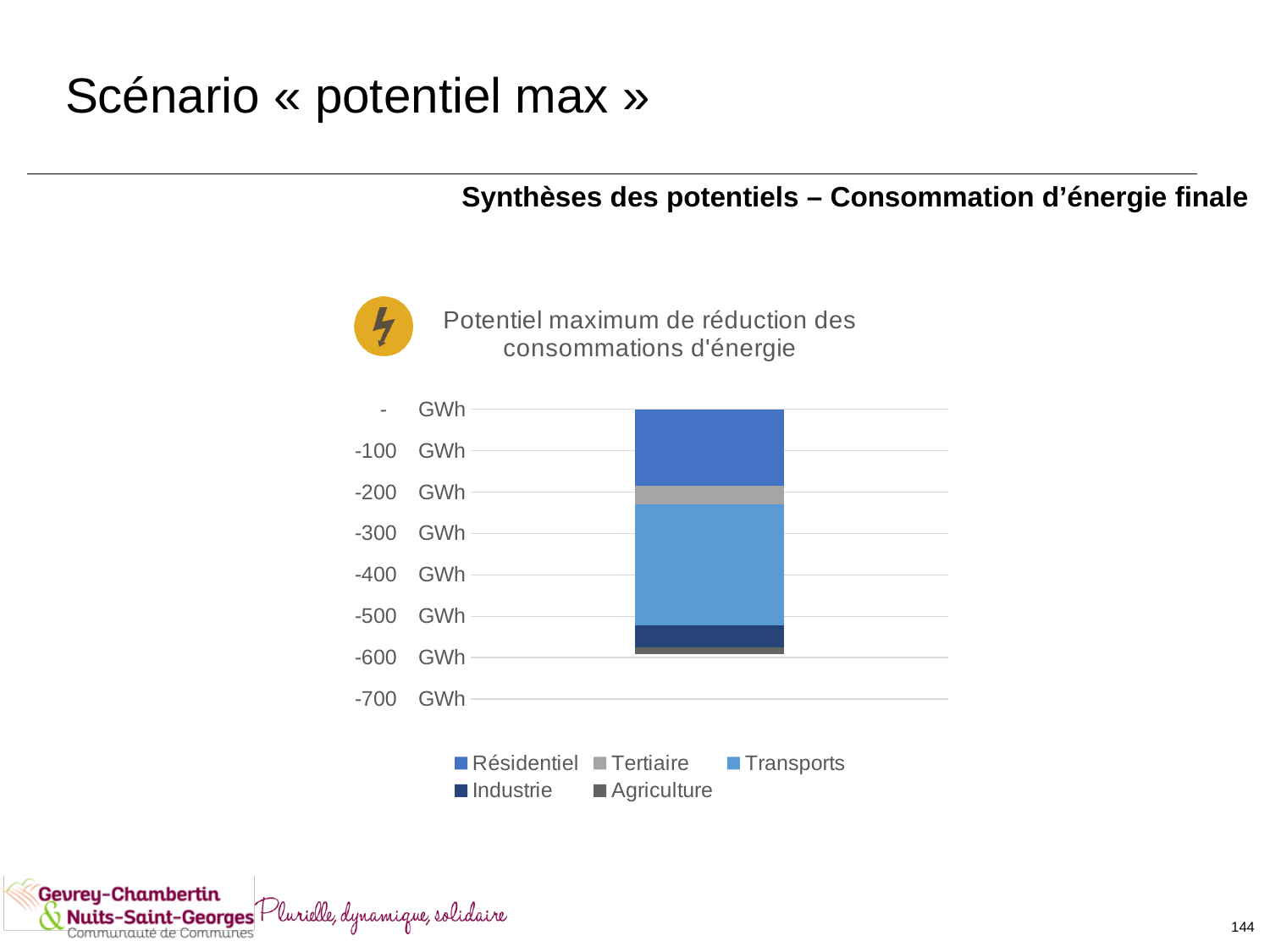
How many series does the chart legend list? 5 Does the bottom of the stacked bar extend below the -500 GWh gridline? Yes What kind of chart is shown on the slide? Stacked bar chart What is the title of the chart? Potentiel maximum de réduction des consommations d'énergie Which segment is larger, Résidentiel or Tertiaire? Résidentiel Which series is plotted at the top of the stacked bar, starting from the - GWh line? Résidentiel How many stacked bars are plotted in the chart? 1 What unit is shown on the chart's vertical axis? GWh Which segment is larger, Industrie or Agriculture? Industrie Which series occupies the smallest segment of the stacked bar? Agriculture Which series occupies the largest segment of the stacked bar? Transports